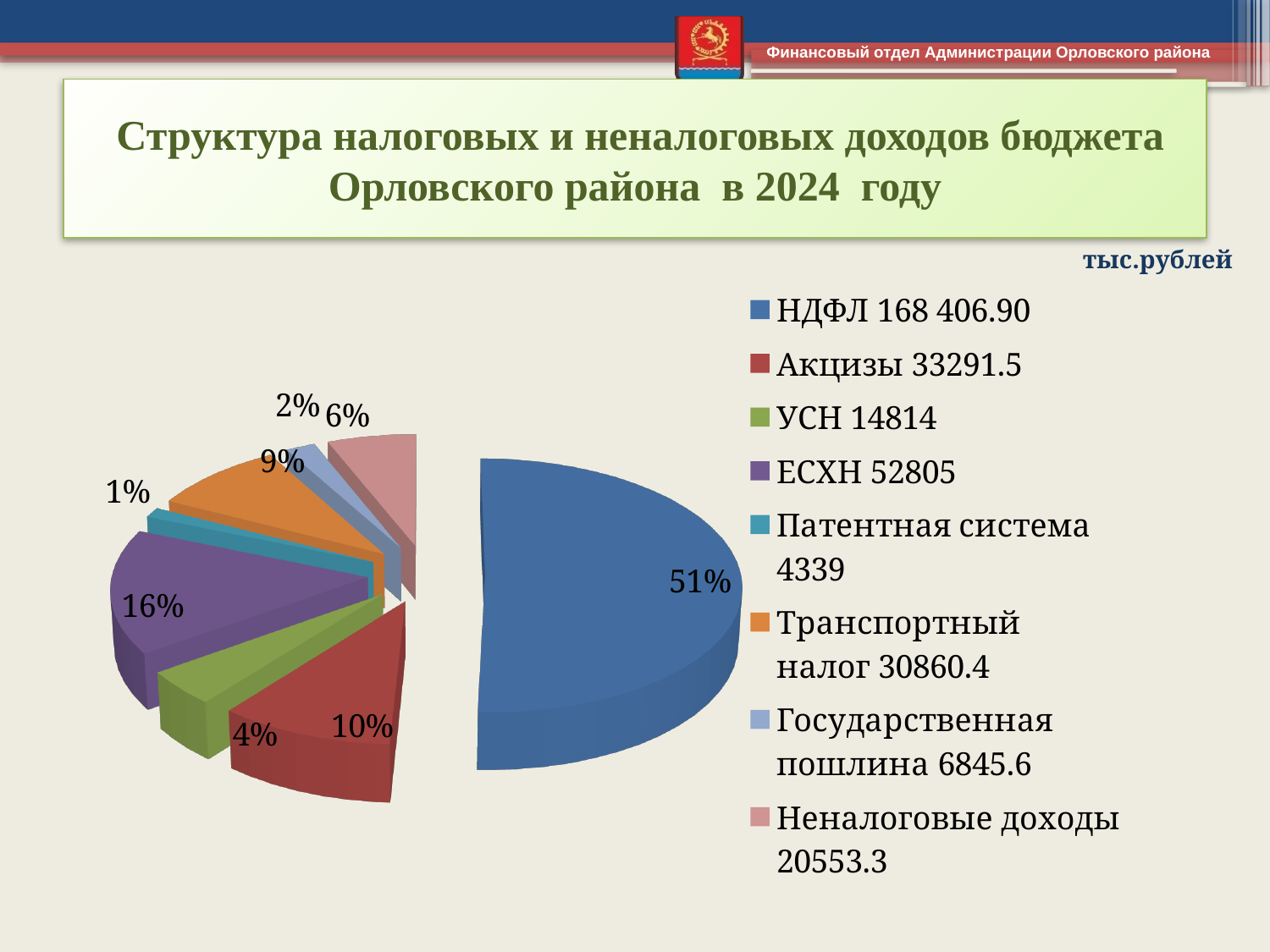
What is the difference between the value for ЕСХН and the value for Акцизы? 19513.5 What value is shown for НДФЛ in the legend? 168 406.90 What share of the pie does НДФЛ account for? 51% What value is shown for Неналоговые доходы in the legend? 20553.3 What share of the pie does ЕСХН account for? 16% How many categories does the legend of the pie chart list? 8 What kind of chart is shown on the slide? pie chart Which category has the largest slice of the pie? НДФЛ What share of the pie does Патентная система account for? 1% Which category has the smallest slice of the pie? Патентная система Which is larger, the value for ЕСХН or the value for Акцизы? ЕСХН What value is shown for Транспортный налог in the legend? 30860.4